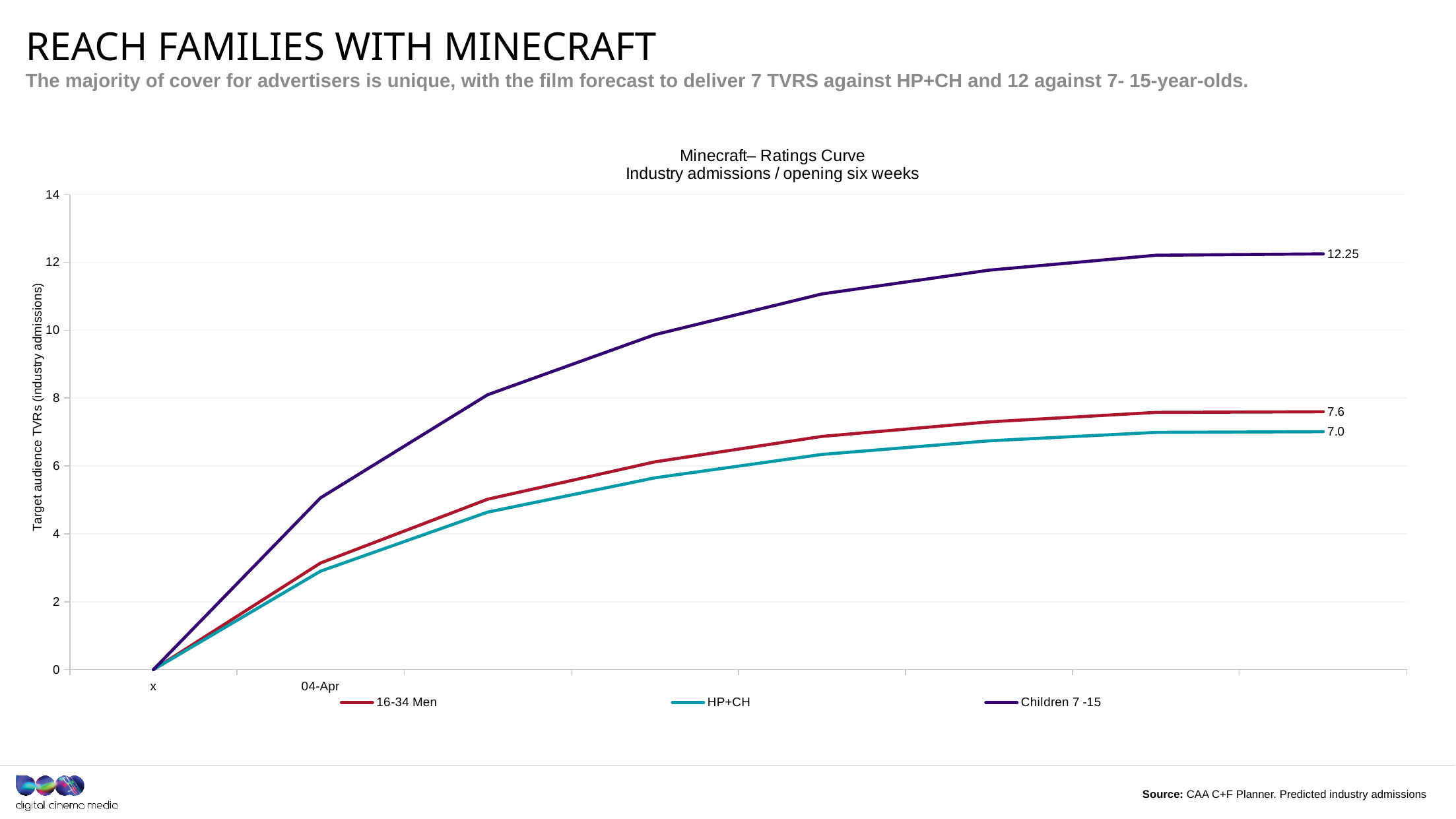
What is the difference between the final values of 16-34 Men and HP+CH? 0.6 What kind of chart is shown on the slide? Line chart Which series ends higher, 16-34 Men or HP+CH? 16-34 Men What is the final value shown for the HP+CH series? 7.0 What is the final value shown for the Children 7 -15 series? 12.25 Do the values rise or fall along the x axis? Rise What is the final value shown for the 16-34 Men series? 7.6 How many series does the legend list? 3 Is the value for Children 7 -15 at 04-Apr greater or less than 4? greater Which series reaches the highest value at the end of the curve? Children 7 -15 What is the difference between the final values of Children 7 -15 and 16-34 Men? 4.65 Which series has the lowest final value? HP+CH